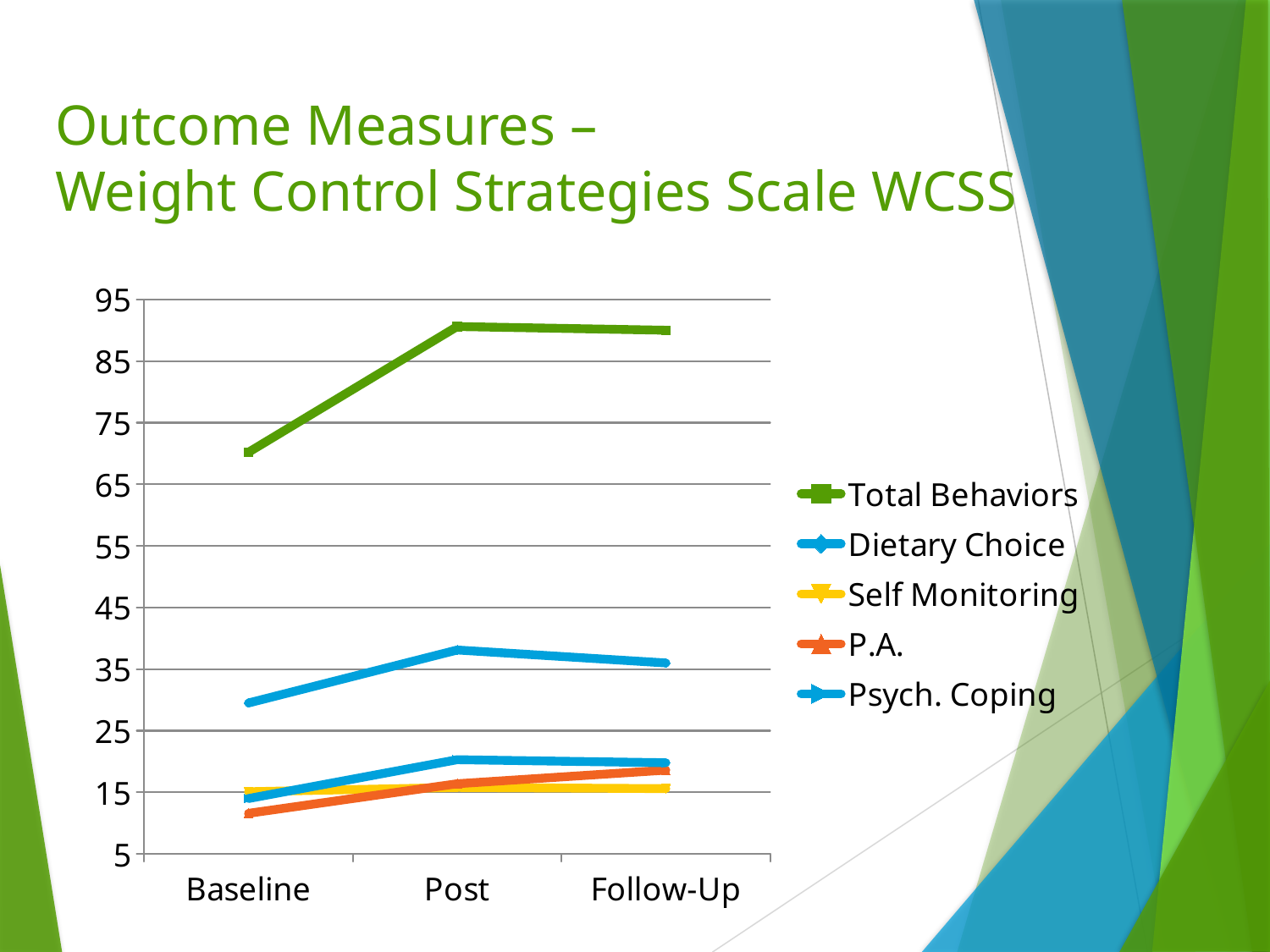
For Total Behaviors, which is larger: the value at Baseline or the value at Post? Post Which series has the lowest value at Baseline? P.A. Is the value for Total Behaviors at Post greater or less than 85? greater What kind of chart is shown on the slide? line chart What are the three categories on the x axis? Baseline, Post, Follow-Up Does the Total Behaviors line rise or fall from Baseline to Post? rises Is the value for Self Monitoring at Follow-Up greater or less than 25? less Is the value for P.A. at Baseline greater or less than 15? less How many time points are shown on the x axis? 3 How many series does the legend list? 5 Which series has the highest value at Post? Total Behaviors